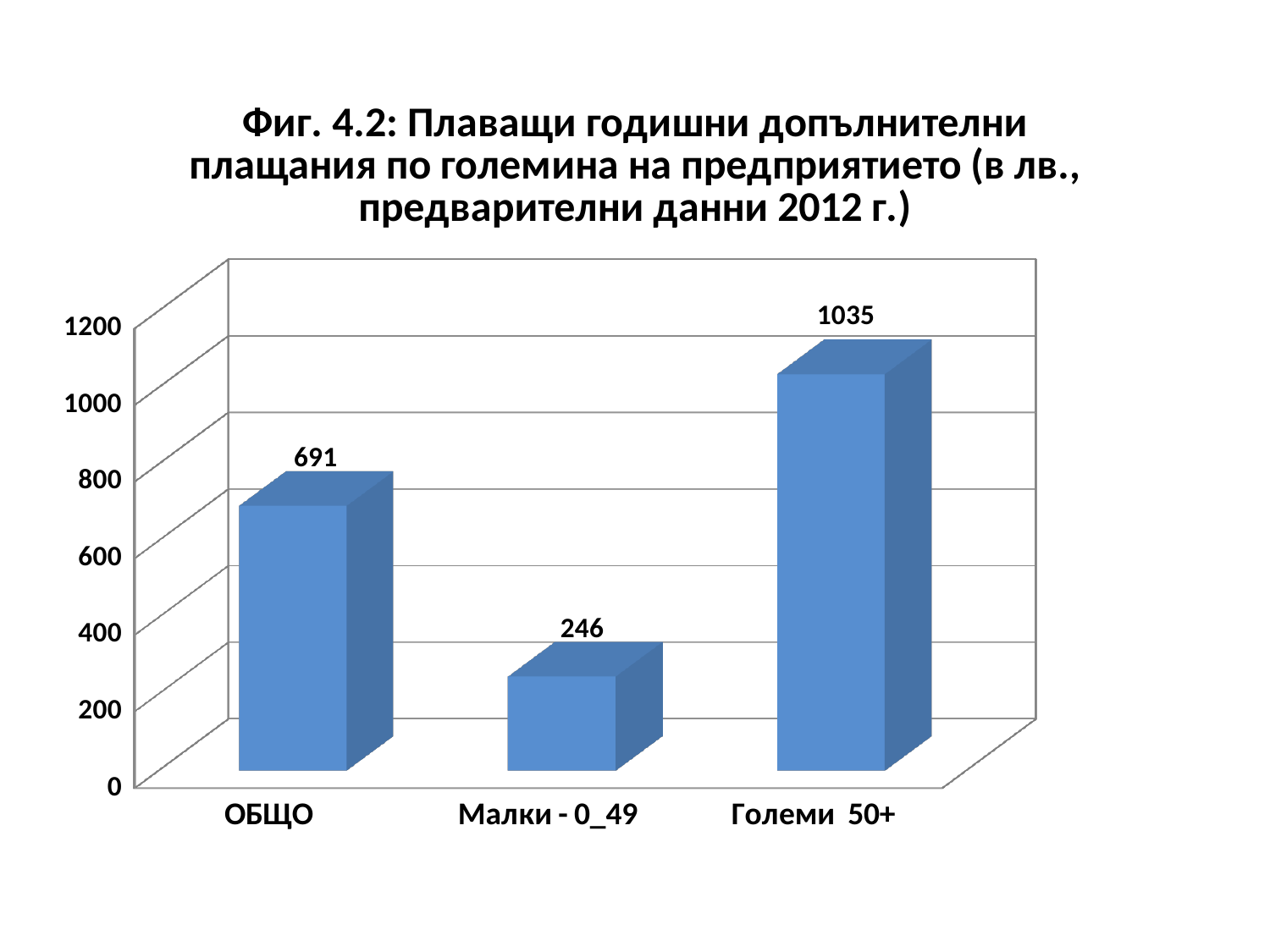
What is the value for Малки - 0_49? 246 Which is larger, the value for ОБЩО or the value for Малки - 0_49? ОБЩО How many categories are shown on the x axis? 3 What kind of chart is shown on the slide? bar chart What is the difference between the values for Големи 50+ and Малки - 0_49? 789 What is the value for Големи 50+? 1035 Which category has the highest value? Големи 50+ What is the highest tick value shown on the vertical axis? 1200 What is the difference between the values for Големи 50+ and ОБЩО? 344 Is the value for Големи 50+ greater or less than 1000? greater Which category has the lowest value? Малки - 0_49 What is the value for ОБЩО? 691